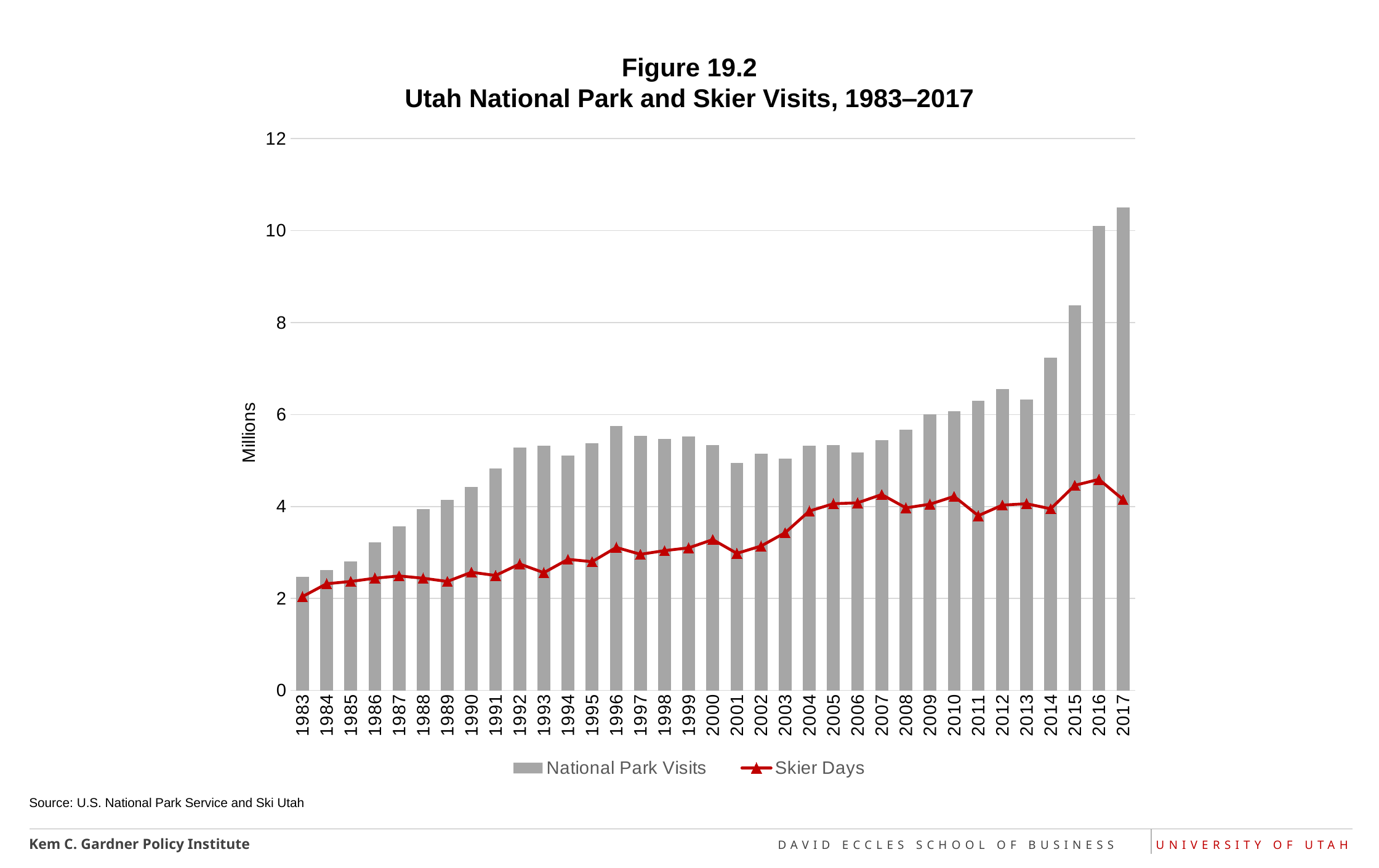
Is the value for National Park Visits in 2017 greater or less than 10? greater Is the value for National Park Visits in 2014 greater or less than 8? less In 2017, which is larger: National Park Visits or Skier Days? National Park Visits Is the value for Skier Days in 2016 greater or less than 4? greater Overall, do National Park Visits rise or fall from 1983 to 2017? rise How many years are shown along the x axis? 35 Which year has the lowest value for National Park Visits? 1983 How many series does the legend list? 2 Which year has the highest value for National Park Visits? 2017 What kind of chart is shown on the slide? A combined bar and line chart Which year has the highest value for Skier Days? 2016